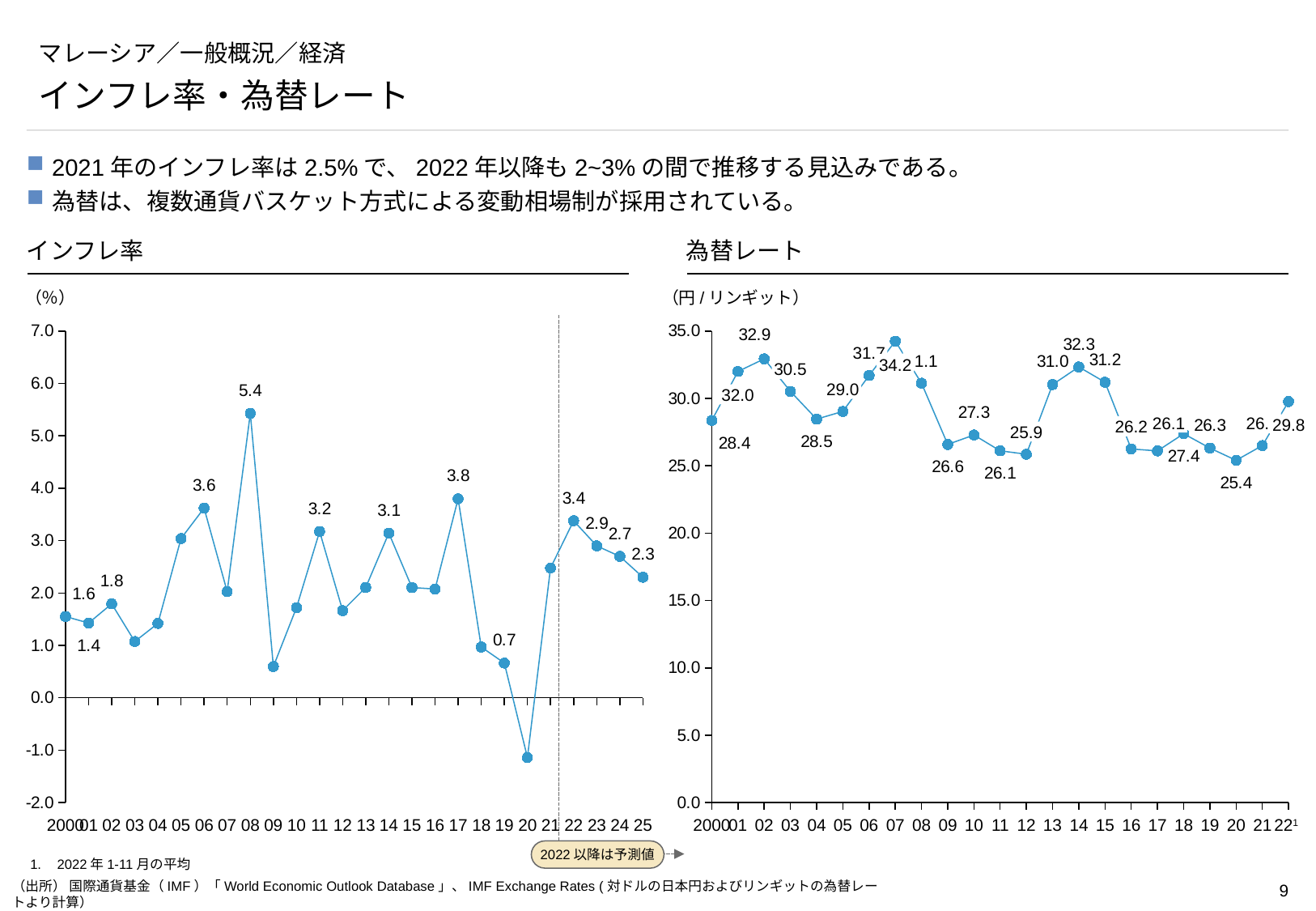
In the 為替レート chart, what is the difference between the values for 2002 and 2000? 4.5 In the インフレ率 chart, which is larger, the value for 2017 or the value for 2014? 2017 In the インフレ率 chart, is the value for 2020 greater or less than 0.0? less In the インフレ率 chart, what is the inflation rate for 2008? 5.4 What unit is shown for the 為替レート chart? 円/リンギット In the インフレ率 chart, which year has the highest inflation rate? 2008 In the 為替レート chart, which year has the highest value? 2007 In the 為替レート chart, what is the lowest value shown? 25.4 In the インフレ率 chart, which year has the lowest inflation rate? 2020 In the インフレ率 chart, what is the difference between the values for 2022 and 2025? 1.1 In the 為替レート chart, what is the value for 2007? 34.2 What kind of chart is the インフレ率 chart on the left? line chart